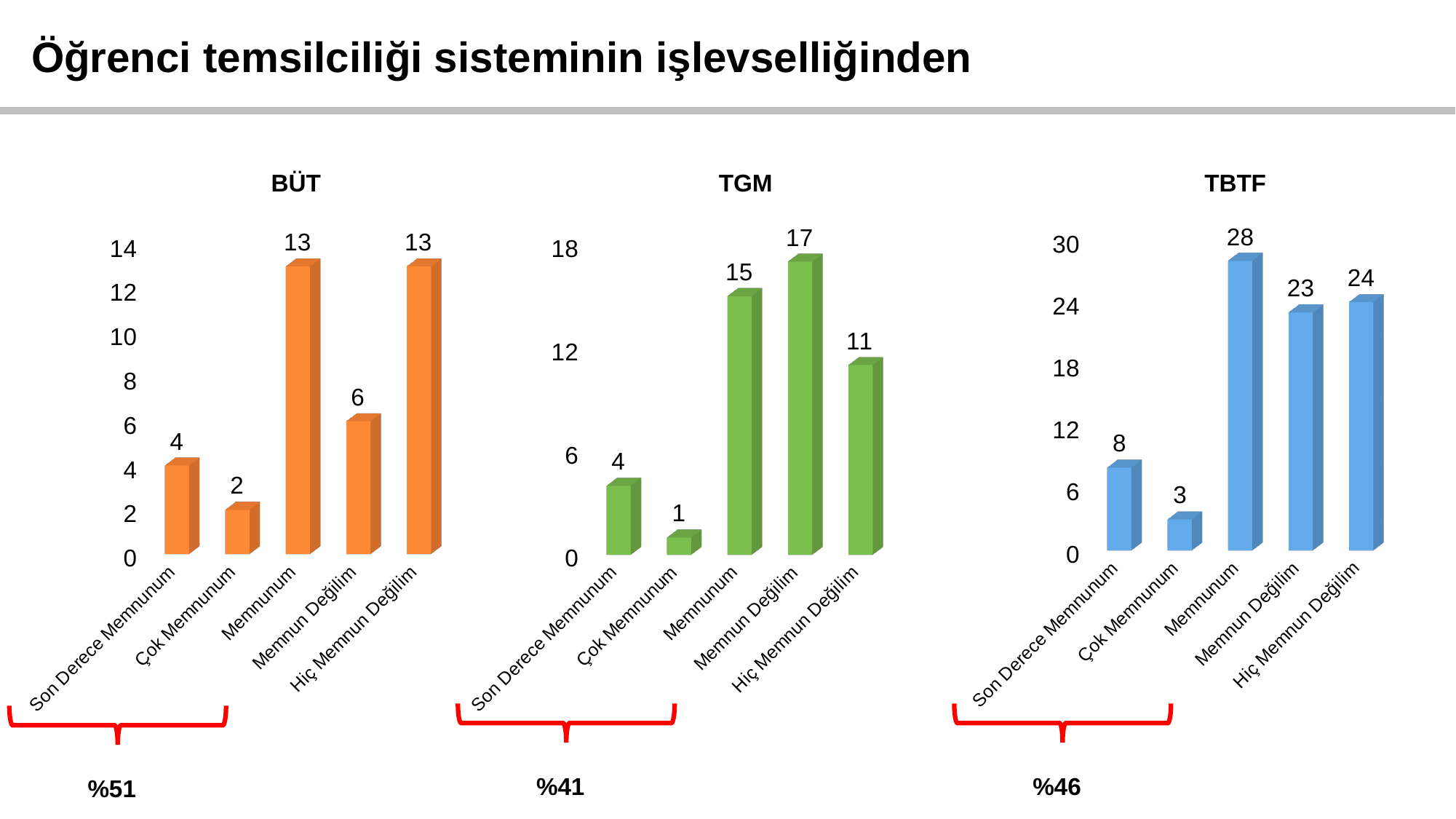
In the TBTF chart, what is the difference between Memnunum and Memnun Değilim? 5 In the TGM chart, what is the difference between Memnun Değilim and Memnunum? 2 In the BÜT chart, what is the value for Memnun Değilim? 6 How many categories does the TGM chart show? 5 What colour are the bars in the TGM chart? green In the BÜT chart, which category has the lowest value? Çok Memnunum In the BÜT chart, which is larger: Son Derece Memnunum or Memnun Değilim? Memnun Değilim In the TBTF chart, what is the value for Son Derece Memnunum? 8 In the TGM chart, what is the value for Hiç Memnun Değilim? 11 What kind of chart is the TBTF chart? bar chart In the TGM chart, which category has the highest value? Memnun Değilim In the TBTF chart, which category has the lowest value? Çok Memnunum